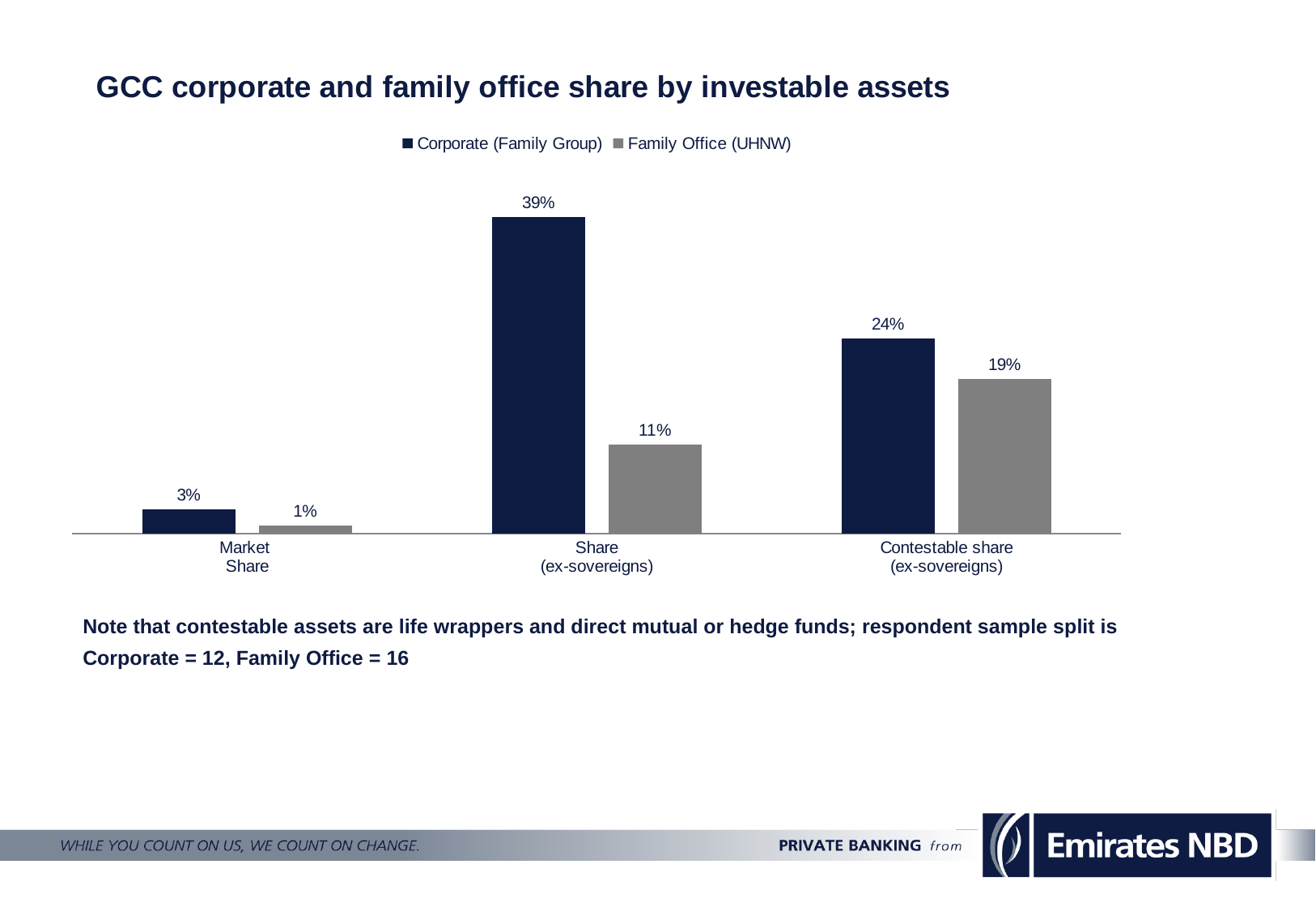
What is the Corporate (Family Group) value for Contestable share (ex-sovereigns)? 24% What is the Corporate (Family Group) value for Share (ex-sovereigns)? 39% Which category has the lowest Family Office (UHNW) value? Market Share What is the Family Office (UHNW) value for Market Share? 1% What is the difference between the Corporate (Family Group) and Family Office (UHNW) values for Share (ex-sovereigns)? 28% How many series does the legend list? 2 How many categories are shown on the x axis? 3 What kind of chart is shown on the slide? Bar chart What is the difference between the Corporate (Family Group) and Family Office (UHNW) values for Contestable share (ex-sovereigns)? 5% Which is larger for Market Share: Corporate (Family Group) or Family Office (UHNW)? Corporate (Family Group) What is the Family Office (UHNW) value for Contestable share (ex-sovereigns)? 19% Which category has the highest Corporate (Family Group) value? Share (ex-sovereigns)